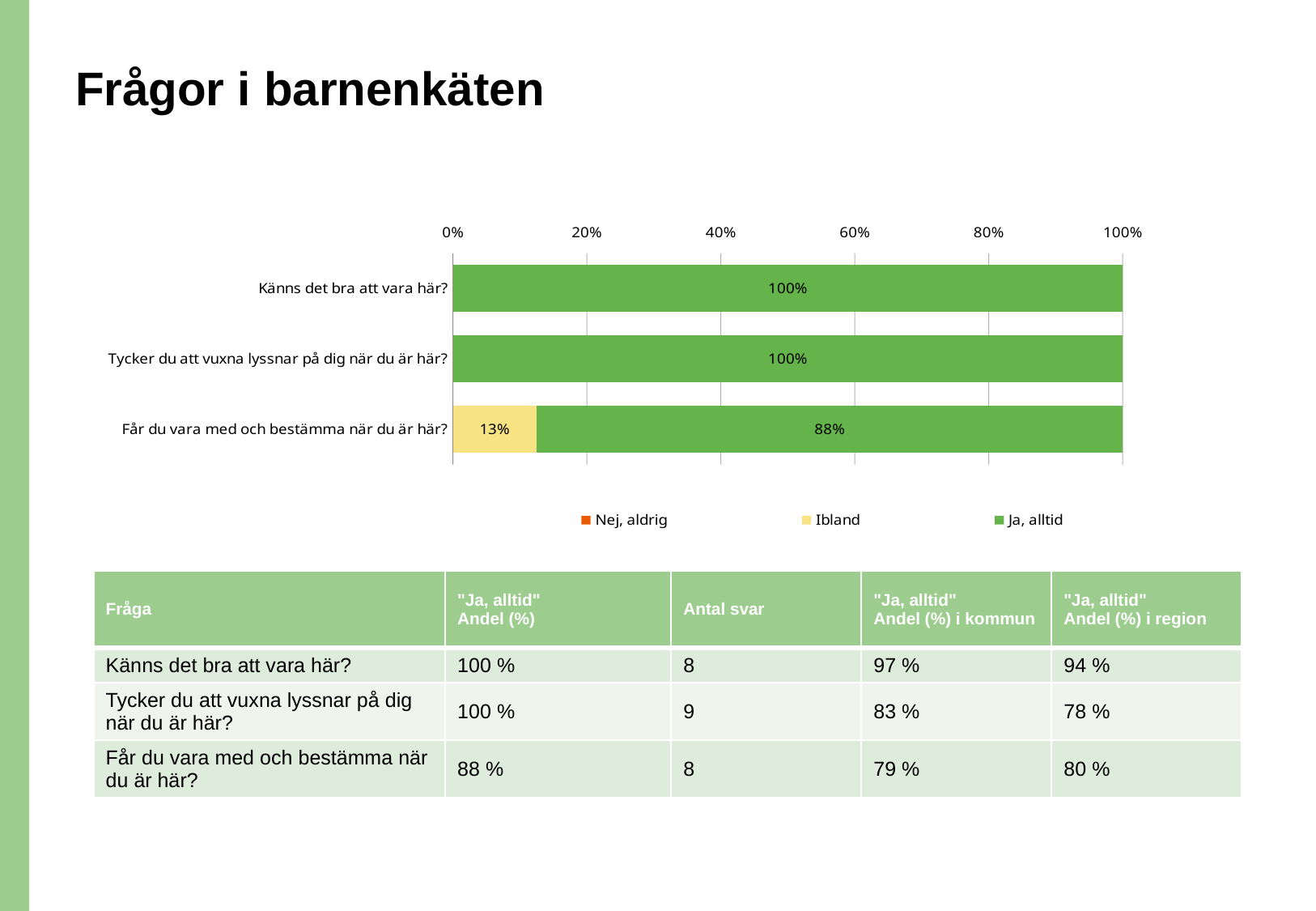
How many series does the chart legend list? 3 What is the "Ja, alltid" value for "Känns det bra att vara här?"? 100% How many categories (questions) are plotted in the chart? 3 Which is larger for "Får du vara med och bestämma när du är här?": the "Ibland" value or the "Ja, alltid" value? Ja, alltid What is the "Ja, alltid" value for "Får du vara med och bestämma när du är här?"? 88% What is the difference between the "Ja, alltid" value for "Känns det bra att vara här?" and for "Får du vara med och bestämma när du är här?"? 12% What kind of chart is shown on the slide? bar chart Is the "Ja, alltid" value for "Får du vara med och bestämma när du är här?" greater or less than 80%? greater What is the "Ibland" value for "Får du vara med och bestämma när du är här?"? 13% Which legend entry is shown in green? Ja, alltid Which category has the lowest "Ja, alltid" value? Får du vara med och bestämma när du är här? What is the "Ja, alltid" value for "Tycker du att vuxna lyssnar på dig när du är här?"? 100%